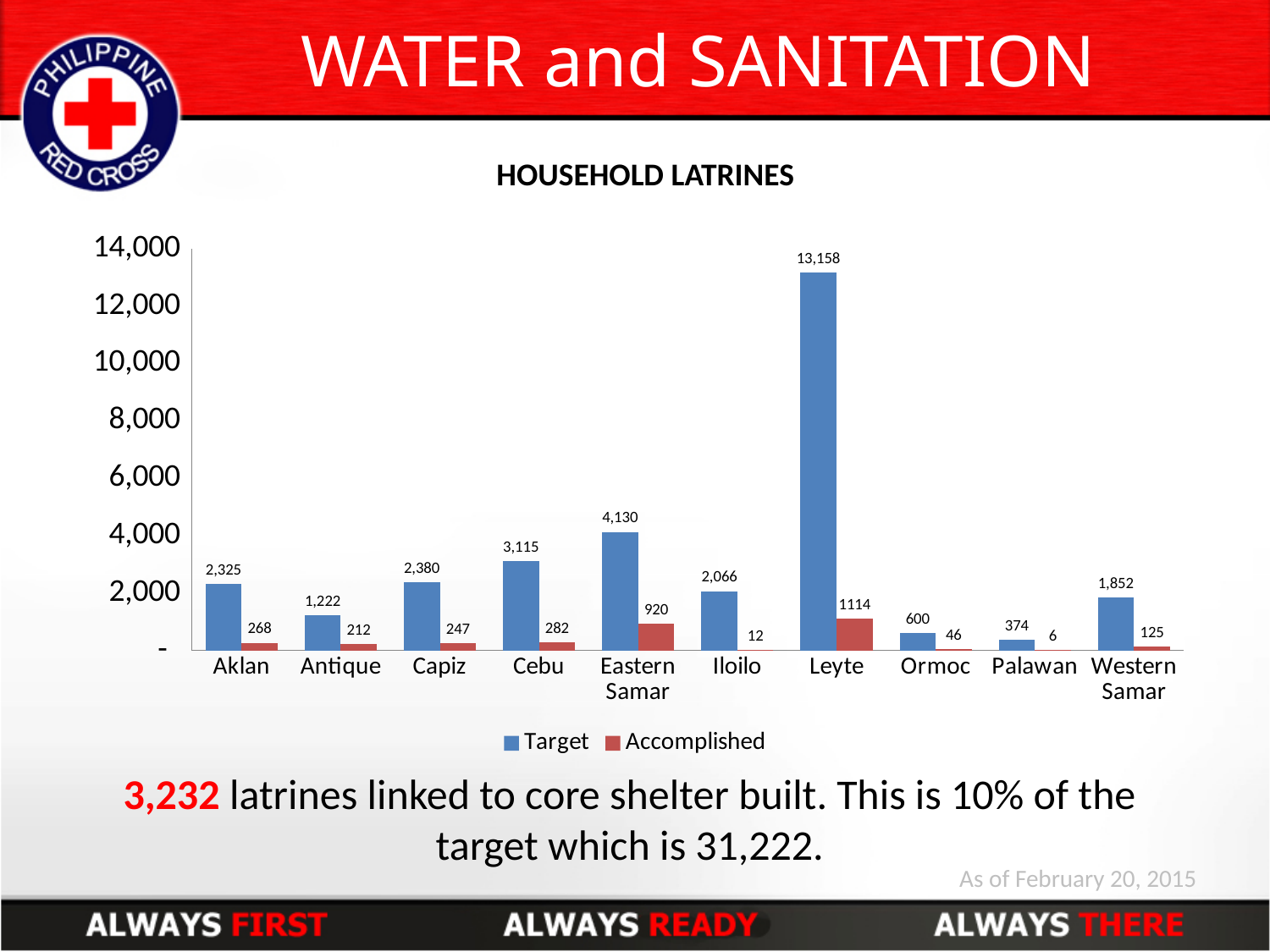
Which is larger, the Target value for Capiz or the Target value for Antique? Capiz What is the Target value for Cebu? 3,115 What kind of chart is shown on the slide? Bar chart Which category has the lowest Target value? Palawan What is the Accomplished value for Eastern Samar? 920 What is the Target value for Leyte? 13,158 What is the difference between the Target and Accomplished values for Aklan? 2,057 What is the title of the chart? HOUSEHOLD LATRINES What is the Accomplished value for Palawan? 6 How many categories are shown on the x axis? 10 Which category has the highest Target value? Leyte How many series does the legend list? 2